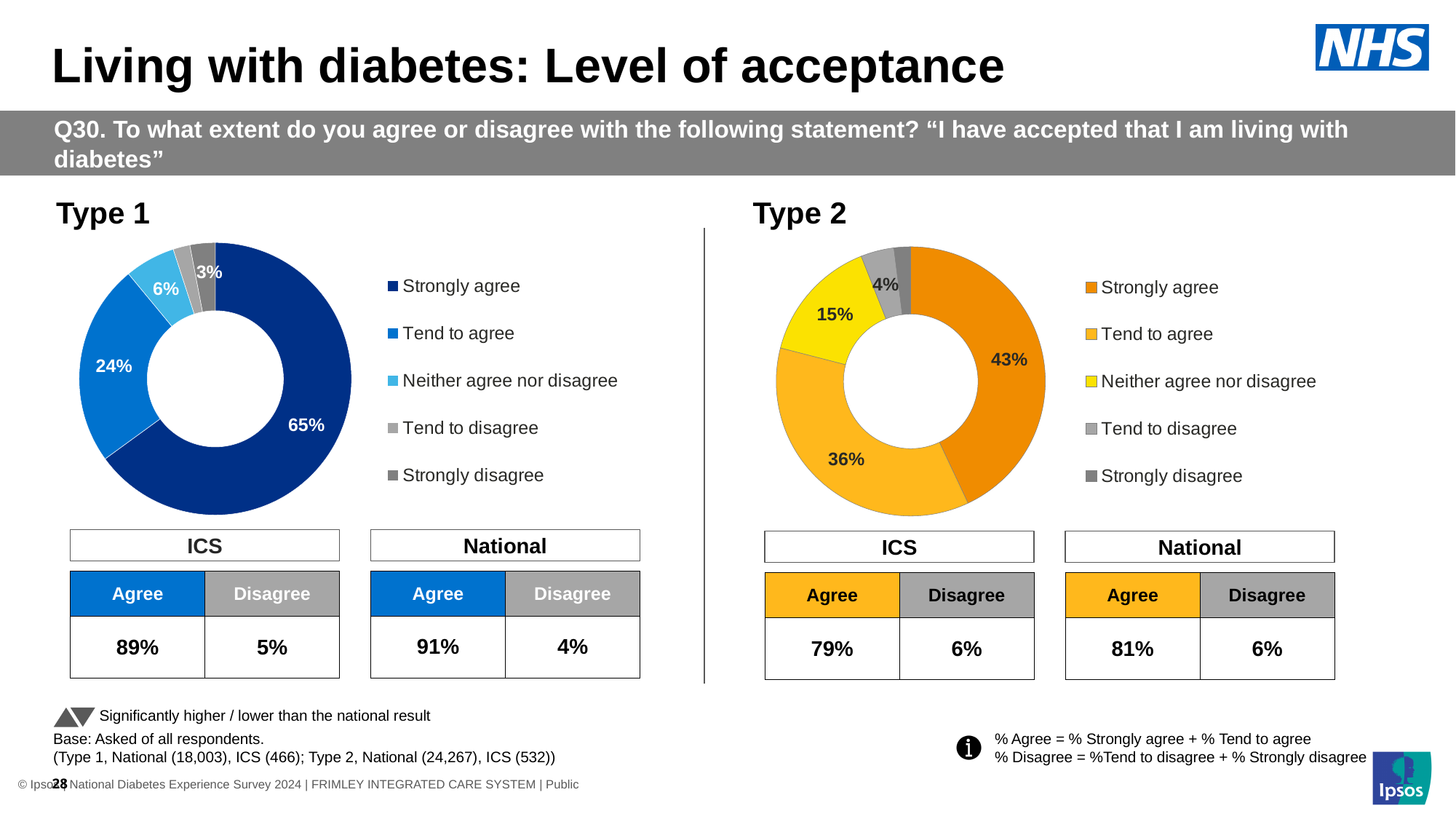
In the Type 2 chart, what percentage of respondents strongly agree? 43% What type of chart is used for Type 1 on the slide? Donut (pie) chart In the Type 2 chart, what percentage of respondents tend to agree? 36% In the Type 1 chart, what percentage neither agree nor disagree? 6% In the Type 1 chart, which response category has the largest share? Strongly agree In the Type 2 chart, which is larger: Strongly agree or Tend to agree? Strongly agree In the Type 1 chart, what percentage of respondents tend to agree? 24% How many response categories does the legend of the Type 2 chart list? 5 What is the difference between the Strongly agree share in the Type 1 chart and the Strongly agree share in the Type 2 chart? 22 percentage points In the Type 1 chart, what percentage of respondents strongly agree? 65% In the Type 2 chart, what percentage neither agree nor disagree? 15% What colour represents Strongly agree in the Type 2 chart? Orange